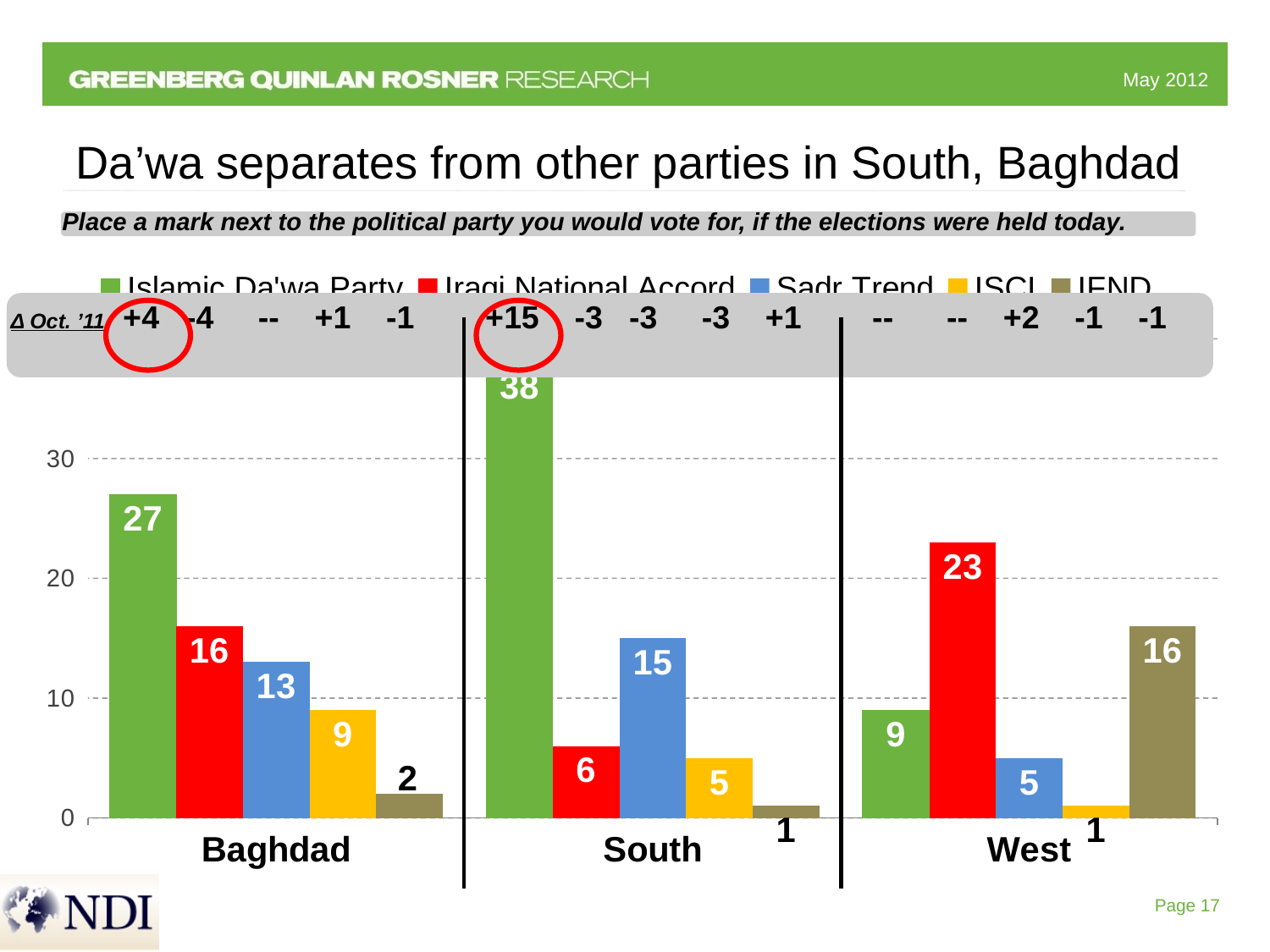
Which is larger in the West: the value for Sadr Trend or the value for IFND? IFND How many regions are shown on the x axis? 3 What value is shown for the Islamic Da'wa Party in the South? 38 Which party has the highest value in the West? Iraqi National Accord What colour are the bars for the Islamic Da'wa Party? Green What value is shown for Sadr Trend in the South? 15 What value is shown for the Iraqi National Accord in the West? 23 What value is shown for the Islamic Da'wa Party in Baghdad? 27 Which party has the lowest value in Baghdad? IFND What is the difference between the Islamic Da'wa Party's value in the South and in Baghdad? 11 What kind of chart is shown on the slide? Bar chart How many series does the legend list? 5